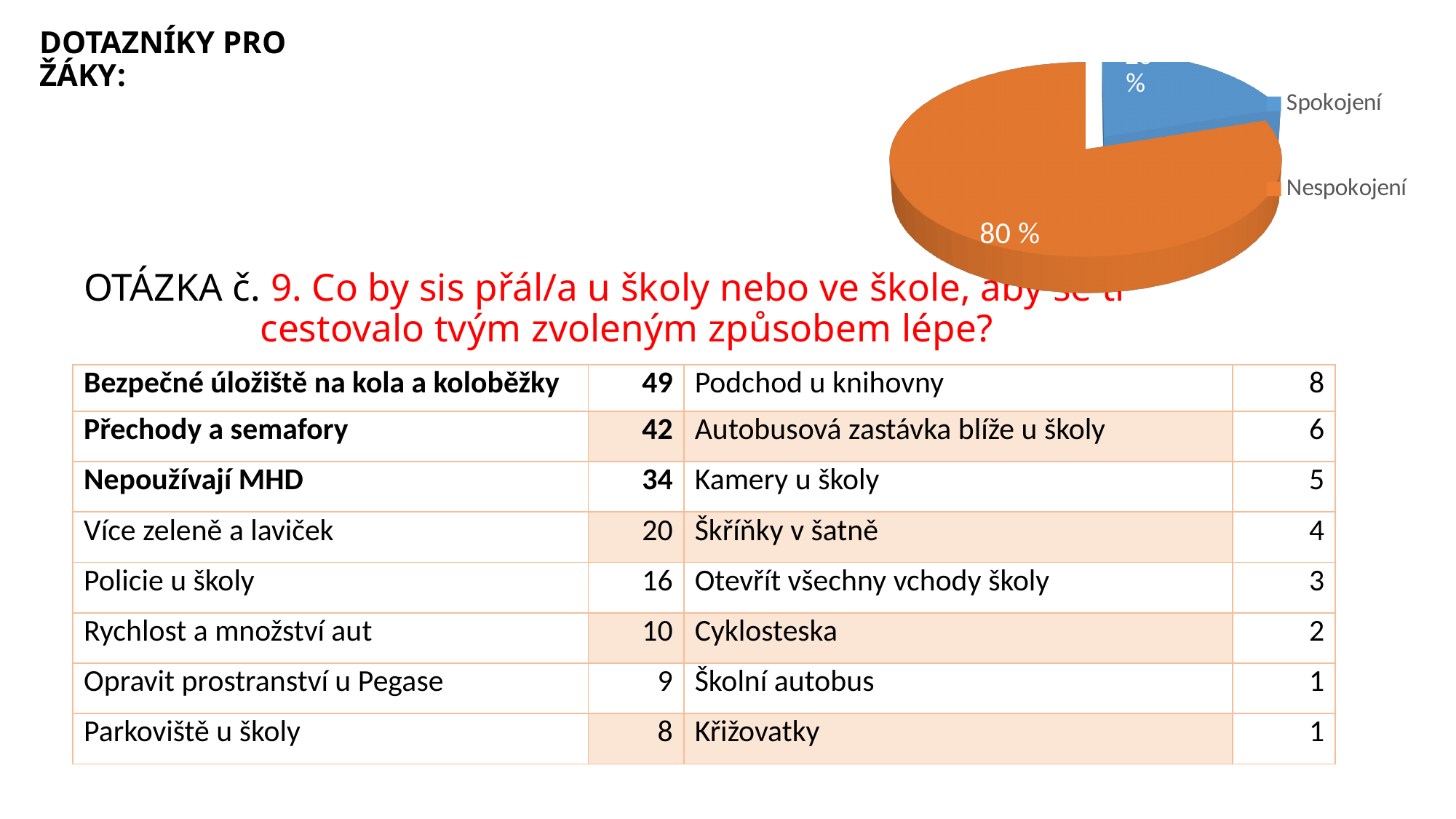
In the pie chart, which slice is larger, Spokojení or Nespokojení? Nespokojení What colour is the Nespokojení slice in the pie chart? orange What kind of chart is shown at the top right of the slide? pie chart Which category has the largest slice in the pie chart? Nespokojení How many categories does the legend of the pie chart list? 2 Which category has the smallest slice in the pie chart? Spokojení What share of the pie chart does the Nespokojení slice represent? 80 % What colour is the Spokojení slice in the pie chart? blue